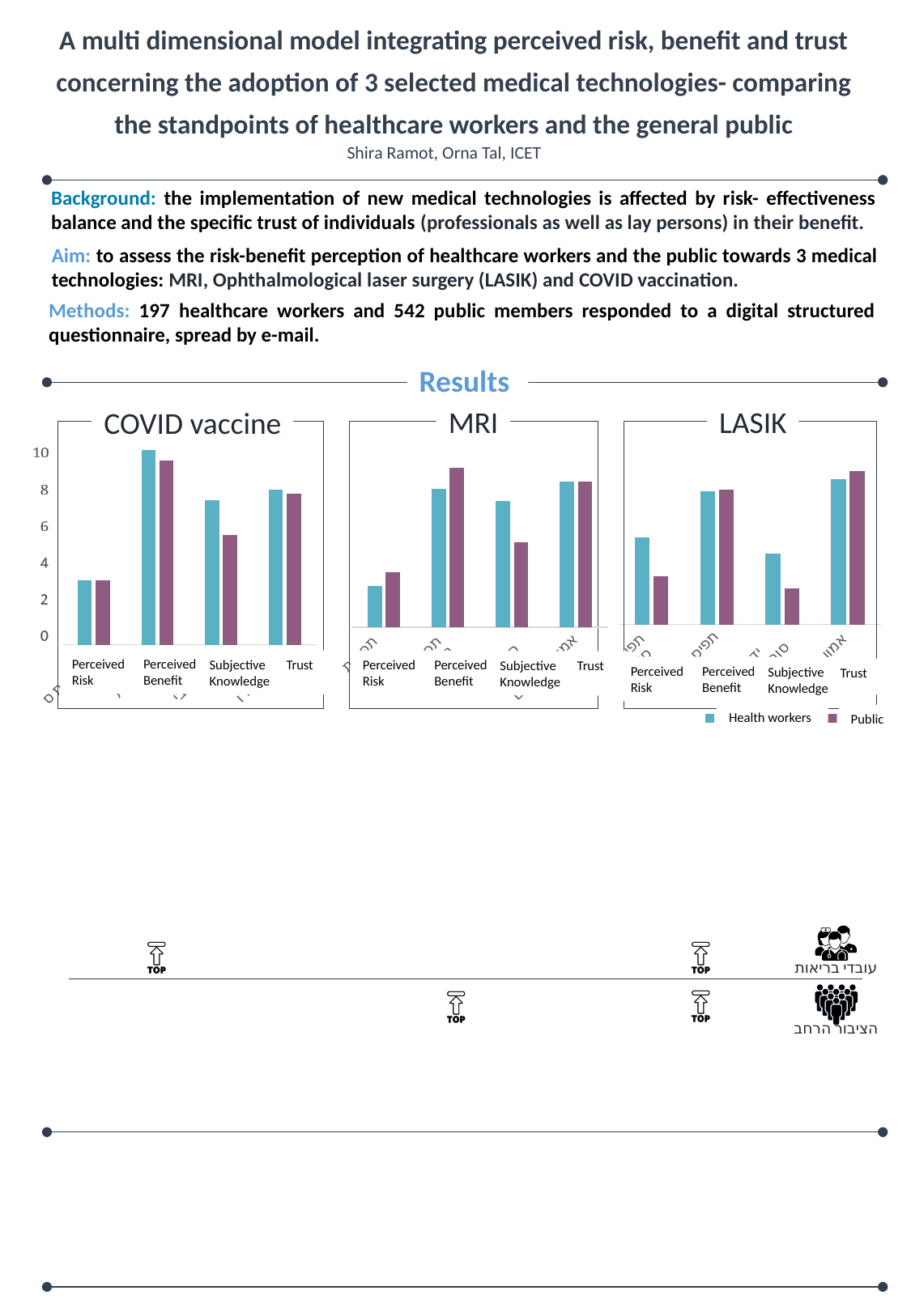
What kind of chart is the COVID vaccine chart? Bar chart In the COVID vaccine chart, is the Health workers value for Perceived Benefit greater or less than 8? greater In the COVID vaccine chart, for Subjective Knowledge, which series has the larger value: Health workers or Public? Health workers In the COVID vaccine chart, which category has the lowest value for Public? Perceived Risk In the LASIK chart, which category has the lowest value for Public? Subjective Knowledge How many categories are shown on the x axis of the COVID vaccine chart? 4 In the COVID vaccine chart, which category has the highest value for Health workers? Perceived Benefit In the LASIK chart, for Perceived Risk, which series has the larger value: Health workers or Public? Health workers In the MRI chart, for Perceived Benefit, which series has the larger value: Health workers or Public? Public In the COVID vaccine chart, is the Public value for Subjective Knowledge greater or less than 6? less What are the two series named in the legend of the charts? Health workers and Public How many series does the legend list for the charts? 2